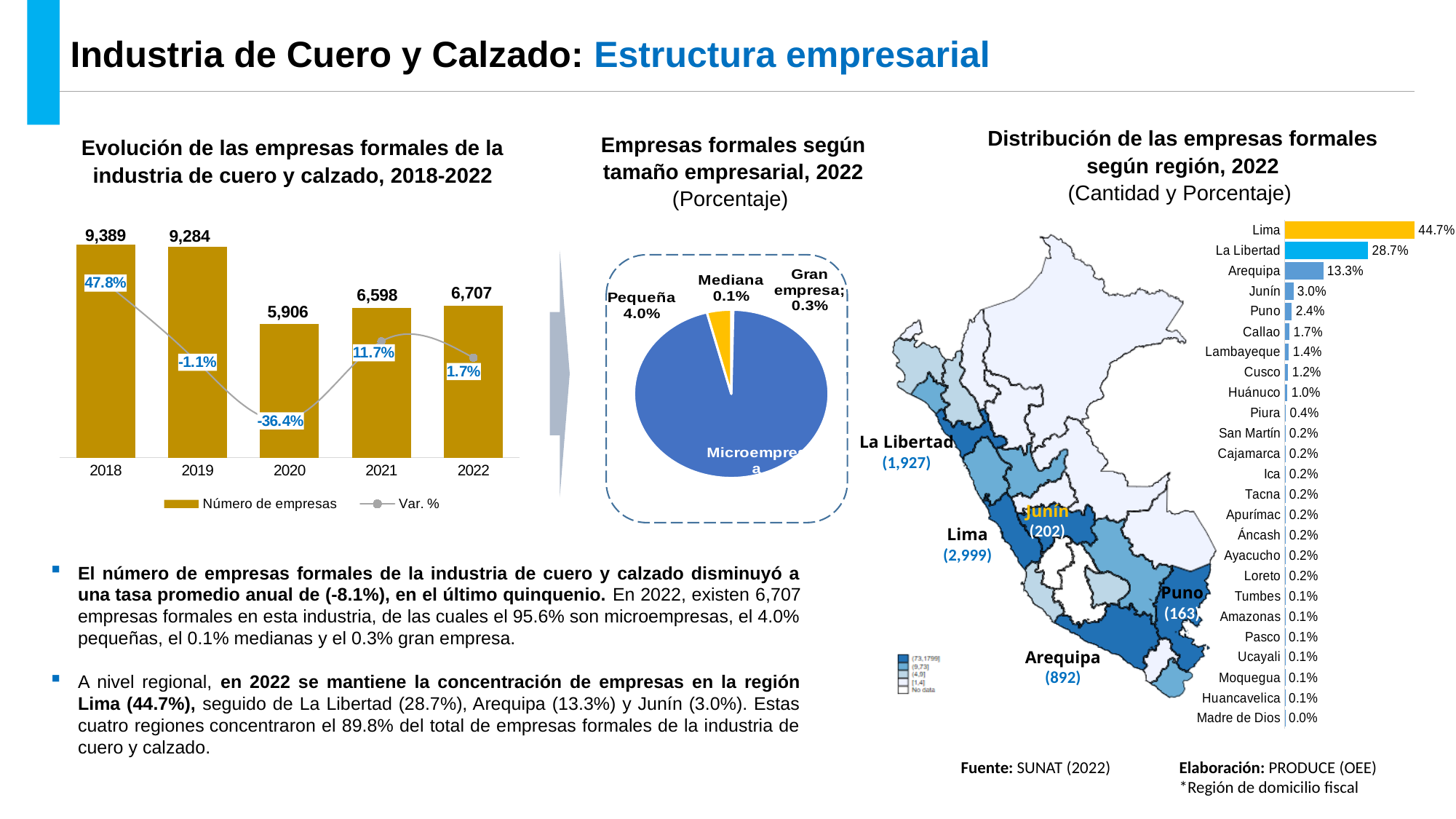
In the chart 'Evolución de las empresas formales de la industria de cuero y calzado, 2018-2022', how many years are shown on the x axis? 5 In the chart 'Evolución de las empresas formales de la industria de cuero y calzado, 2018-2022', what is the difference in the number of companies between 2022 and 2021? 109 In the chart 'Evolución de las empresas formales de la industria de cuero y calzado, 2018-2022', how many series does the legend list? 2 In the chart 'Empresas formales según tamaño empresarial, 2022', what share does 'Pequeña' have? 4.0% In the chart 'Distribución de las empresas formales según región, 2022', what is the value for La Libertad? 28.7% What kind of chart is 'Empresas formales según tamaño empresarial, 2022'? Pie chart In the chart 'Distribución de las empresas formales según región, 2022', which is larger, Arequipa or Junín? Arequipa In the chart 'Distribución de las empresas formales según región, 2022', how many regions are listed? 25 In the chart 'Evolución de las empresas formales de la industria de cuero y calzado, 2018-2022', what is the Var. % value for 2020? -36.4% In the chart 'Evolución de las empresas formales de la industria de cuero y calzado, 2018-2022', which year has the highest number of companies? 2018 In the chart 'Distribución de las empresas formales según región, 2022', which region has the highest value? Lima In the chart 'Evolución de las empresas formales de la industria de cuero y calzado, 2018-2022', what is the number of companies in 2020? 5,906